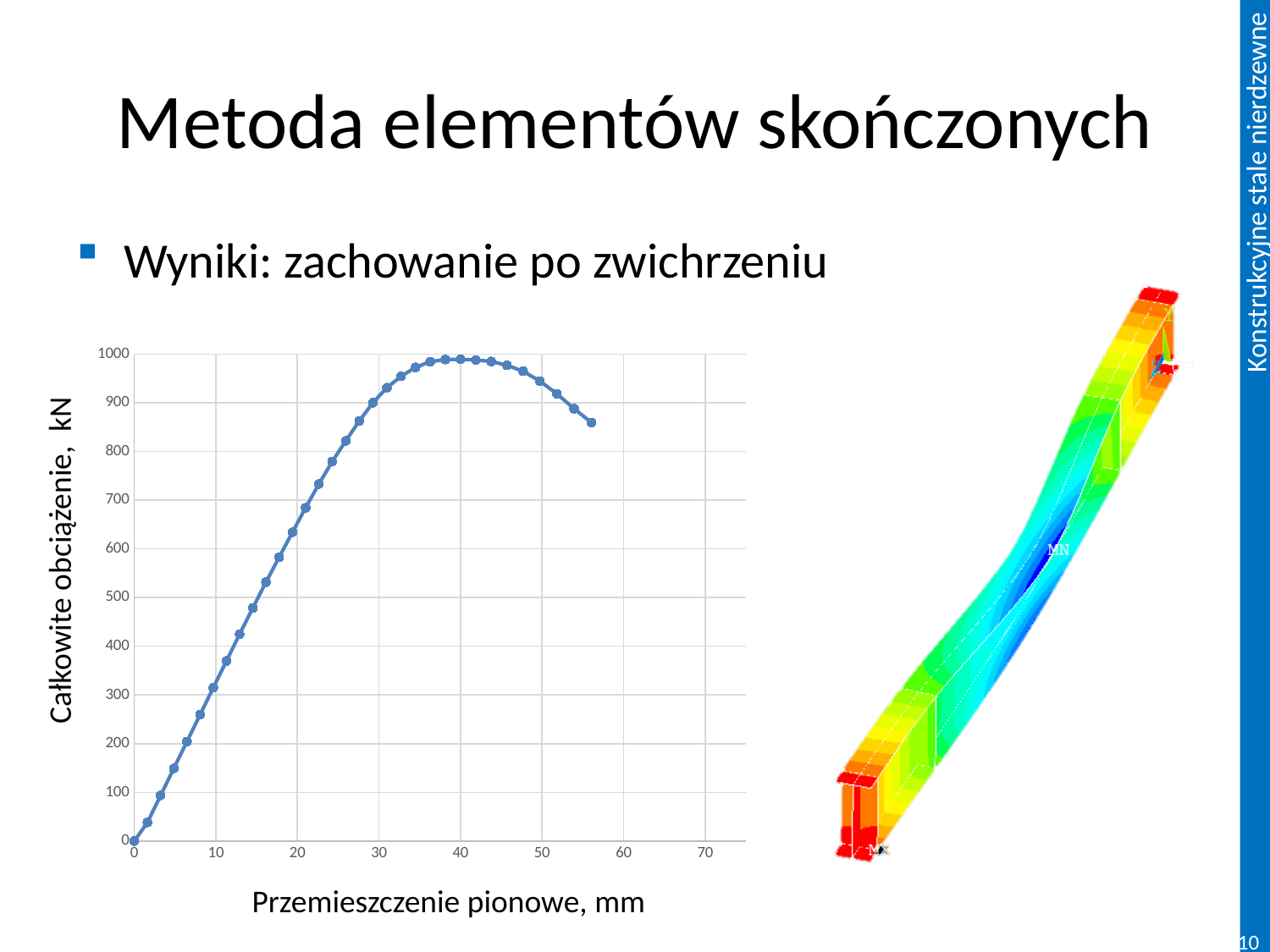
Is the maximum load reached on the curve greater or less than 1000 kN? less Does the load rise or fall as the vertical displacement increases from 0 mm to 30 mm? rise Is the load at a vertical displacement of 20 mm greater or less than 600 kN? greater What is the title of the y axis of the chart? Całkowite obciążenie, kN What is the load value at a vertical displacement of 0 mm? 0 What kind of chart is shown on the slide? line chart Is the load at the last plotted point (around 56 mm) greater or less than 900 kN? less What is the title of the x axis of the chart? Przemieszczenie pionowe, mm Does the load rise or fall as the vertical displacement increases from 45 mm to 55 mm? fall